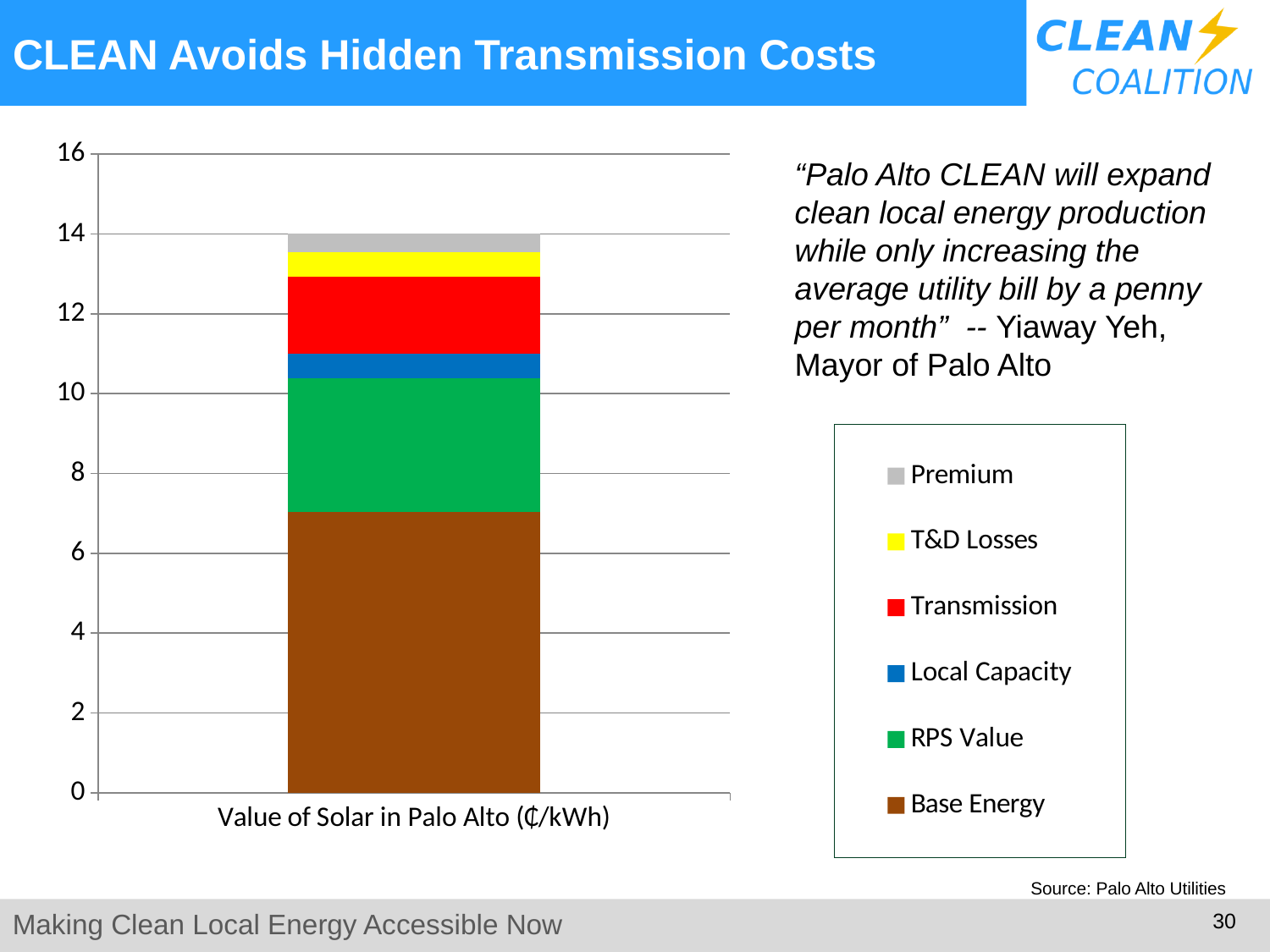
Which series makes up the largest segment of the stacked bar? Base Energy Is the Base Energy segment greater or less than 6? greater How many bars (categories) are plotted in the chart? 1 Is the Base Energy segment greater or less than 8? less What is the highest value shown on the y axis? 16 How many series does the legend list? 6 What is the category label shown on the x axis? Value of Solar in Palo Alto (₵/kWh) What kind of chart is shown on the slide? Stacked bar chart Is the total height of the stacked bar greater or less than 12? greater What colour represents Transmission in the legend? Red Which is larger, the Transmission segment or the Local Capacity segment? Transmission Which is larger, the Base Energy segment or the RPS Value segment? Base Energy